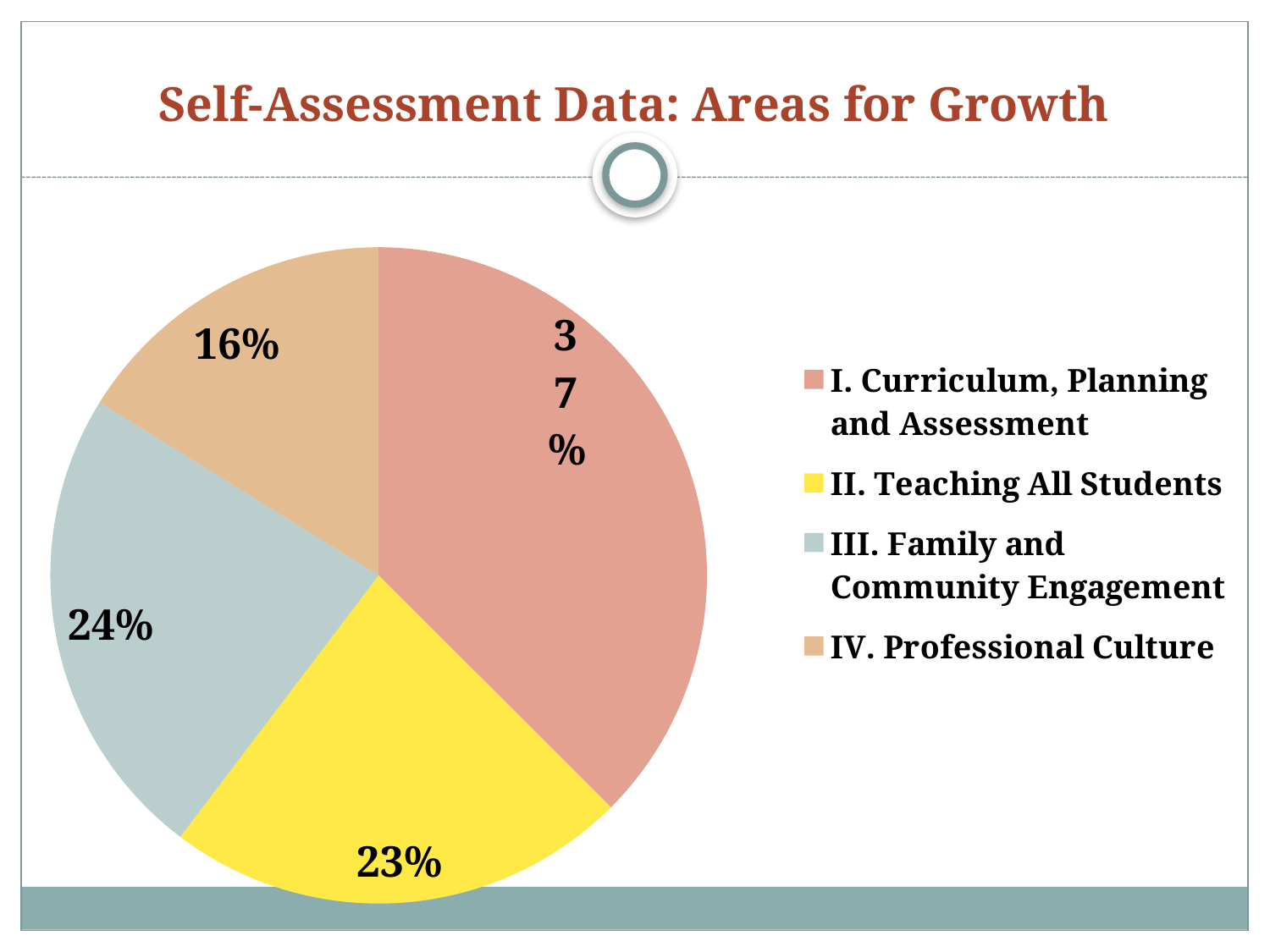
Which is larger: the slice for II. Teaching All Students or the slice for IV. Professional Culture? II. Teaching All Students Which category has the largest slice of the pie? I. Curriculum, Planning and Assessment Which category has the smallest slice of the pie? IV. Professional Culture What is the difference in percentage points between I. Curriculum, Planning and Assessment and IV. Professional Culture? 21 What is the difference in percentage points between III. Family and Community Engagement and II. Teaching All Students? 1 What share of the pie does I. Curriculum, Planning and Assessment represent? 37% What is the title of the slide containing the pie chart? Self-Assessment Data: Areas for Growth How many categories does the pie chart have? 4 What share of the pie does III. Family and Community Engagement represent? 24% What share of the pie does IV. Professional Culture represent? 16% What kind of chart is shown on the slide? pie chart